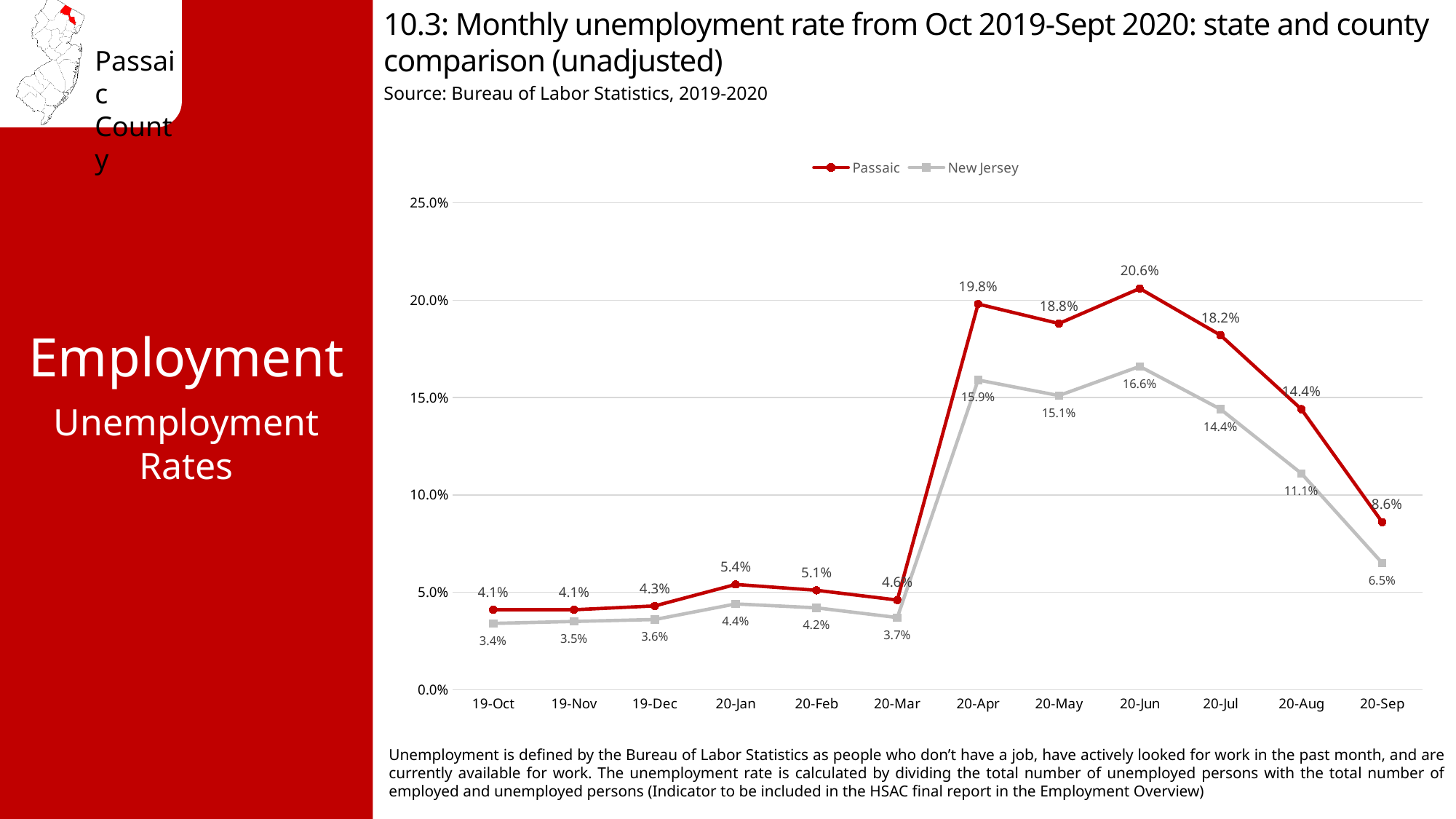
What was the Passaic unemployment rate in 19-Oct? 4.1% How many months are shown on the x axis? 12 What was the Passaic unemployment rate in 20-Jun? 20.6% In which month did New Jersey have its lowest unemployment rate? 19-Oct Did the Passaic unemployment rate rise or fall from 20-Jun to 20-Sep? Fall What is the difference between the Passaic and New Jersey unemployment rates in 20-Jun? 4.0% What type of chart is shown? Line chart What was the New Jersey unemployment rate in 20-Apr? 15.9% How many series does the legend list? 2 In which month did Passaic have its highest unemployment rate? 20-Jun What was the New Jersey unemployment rate in 20-Sep? 6.5% Which had the higher unemployment rate in 20-Aug, Passaic or New Jersey? Passaic